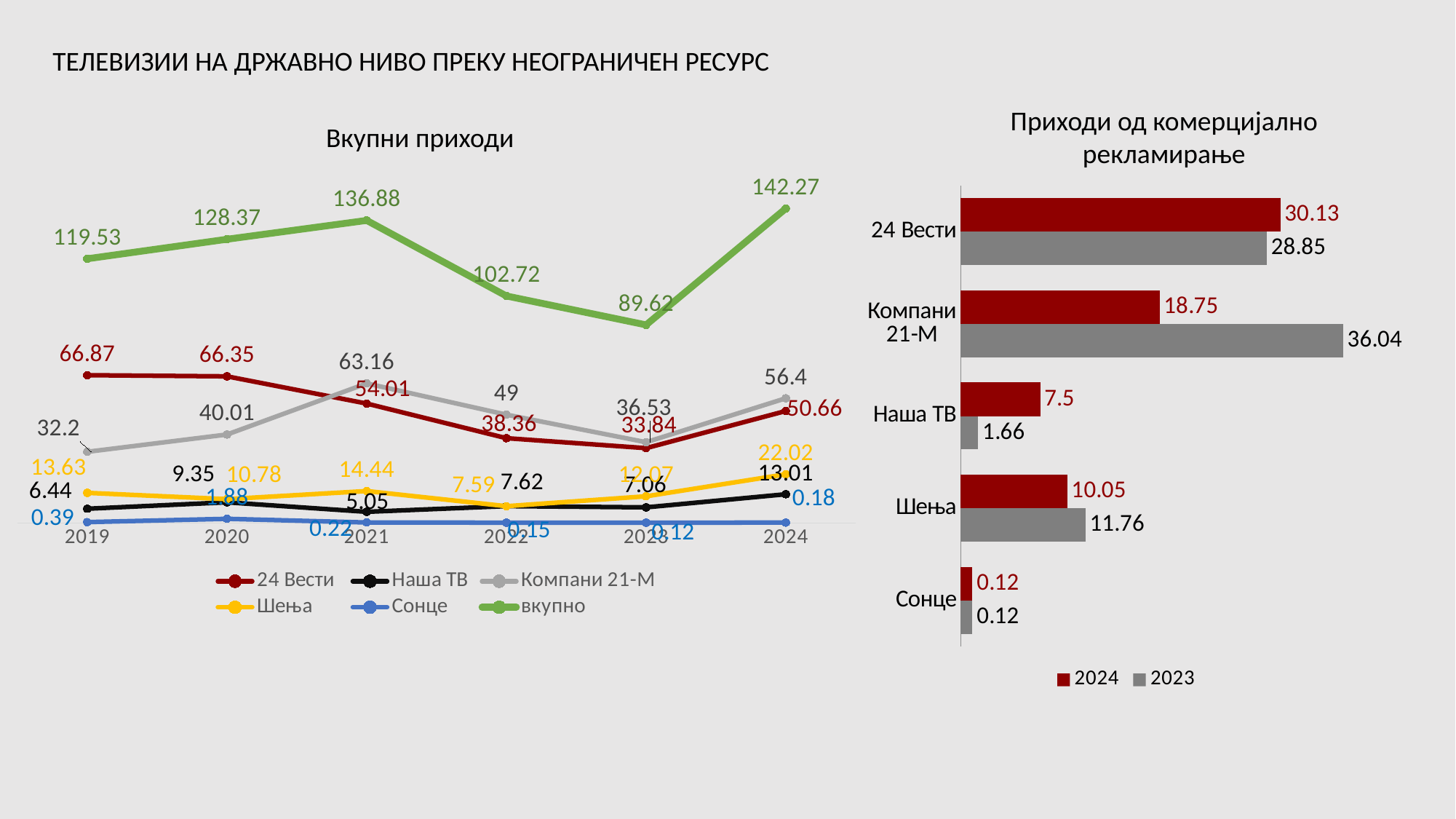
In the 'Вкупни приходи' chart, what is the difference between the '24 Вести' values in 2019 and 2024? 16.21 In the 'Приходи од комерцијално рекламирање' chart, which category has the highest 2024 value? 24 Вести In the 'Приходи од комерцијално рекламирање' chart, what is the difference between the 2024 and 2023 values for 'Наша ТВ'? 5.84 What kind of chart is 'Приходи од комерцијално рекламирање'? bar chart How many categories are shown in the 'Приходи од комерцијално рекламирање' chart? 5 In the 'Вкупни приходи' chart, what is the value for 'Компани 21-М' in 2021? 63.16 In the 'Приходи од комерцијално рекламирање' chart, what is the 2023 value for 'Компани 21-М'? 36.04 In the 'Вкупни приходи' chart, what is the value of the 'вкупно' series in 2024? 142.27 In the 'Вкупни приходи' chart, which is larger in 2022: '24 Вести' or 'Компани 21-М'? Компани 21-М How many series does the legend of the 'Вкупни приходи' chart list? 6 In the 'Вкупни приходи' chart, in which year is the 'вкупно' series lowest? 2023 In the 'Вкупни приходи' chart, does the '24 Вести' series rise or fall from 2019 to 2023? fall